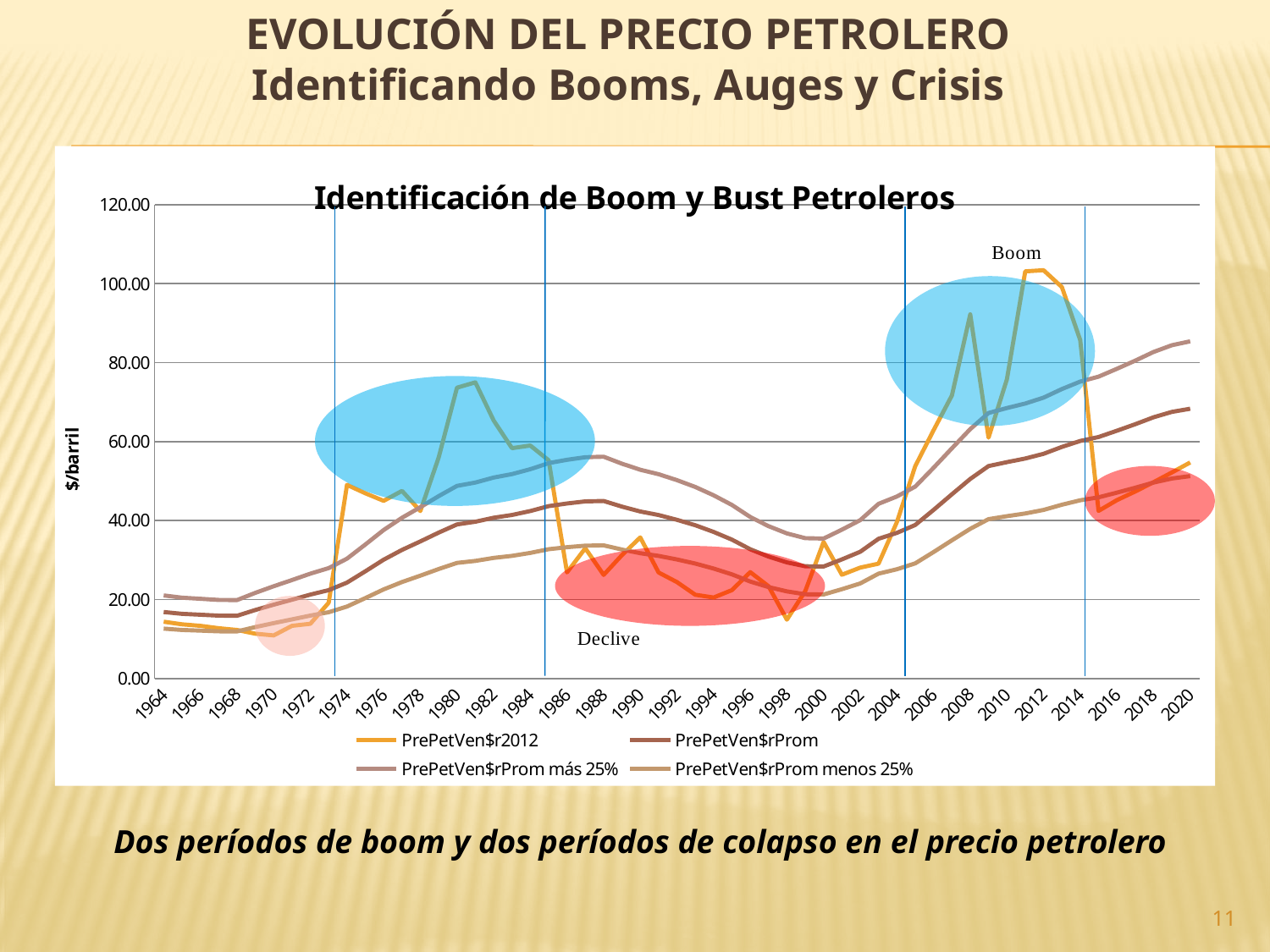
Does the PrePetVen$rProm más 25% series rise or fall between 2000 and 2020? rise Is the value of PrePetVen$rProm menos 25% in 2020 greater or less than 60? less Is the value of PrePetVen$rProm más 25% in 2020 greater or less than 80? greater Is the value of PrePetVen$r2012 in 2012 greater or less than 80? greater In 1998, which series has the lower value: PrePetVen$r2012 or PrePetVen$rProm menos 25%? PrePetVen$r2012 How many series does the chart legend list? 4 What is the title of the chart? Identificación de Boom y Bust Petroleros What kind of chart is shown on the slide? line chart What is the label on the vertical axis of the chart? $/barril In 2020, which series has the higher value: PrePetVen$rProm más 25% or PrePetVen$rProm menos 25%? PrePetVen$rProm más 25%